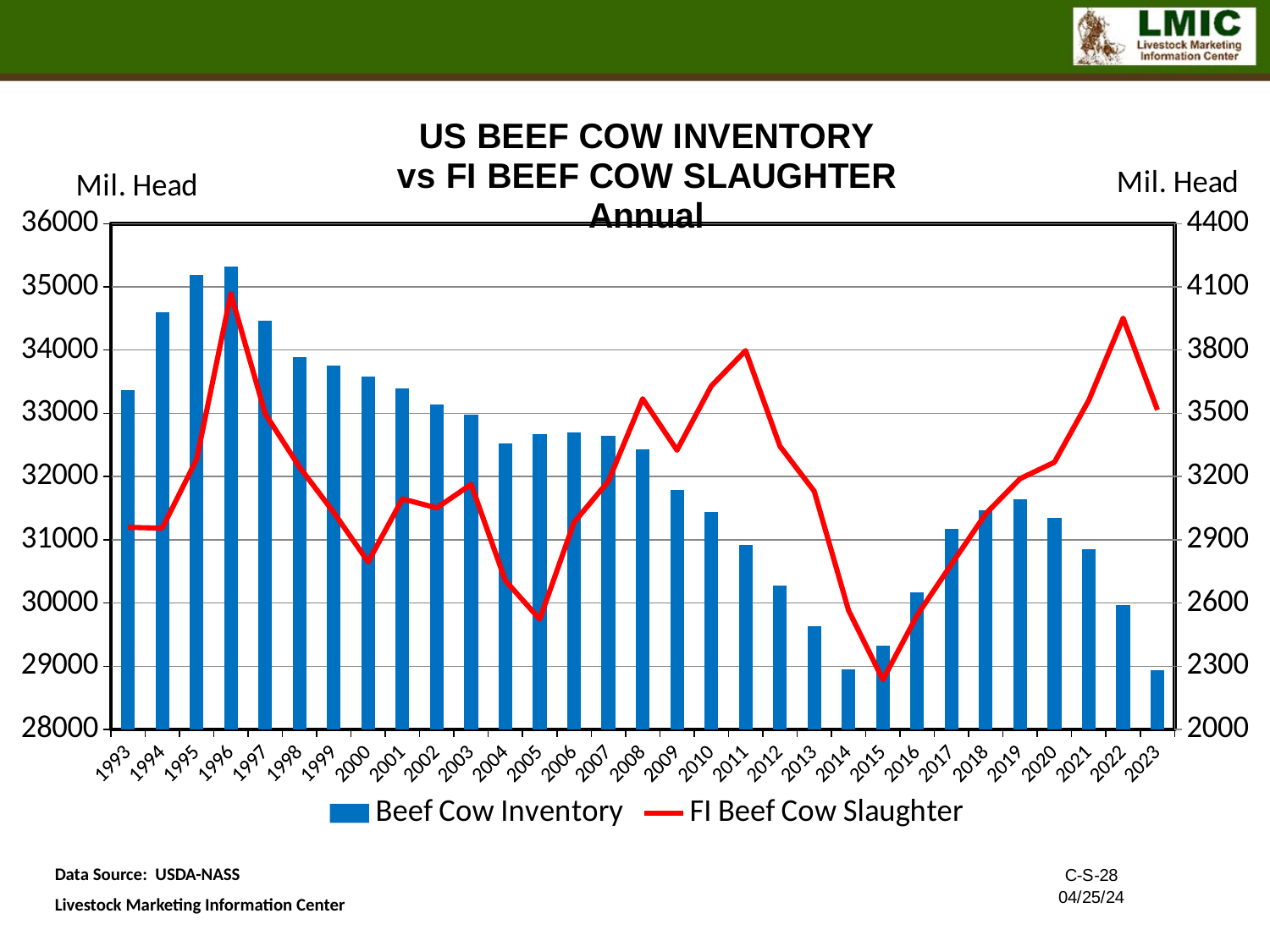
Which year has the larger Beef Cow Inventory, 1994 or 1995? 1995 Is the Beef Cow Inventory value for 2015 greater or less than 30000? less What is the title of the chart? US BEEF COW INVENTORY vs FI BEEF COW SLAUGHTER Annual Do the Beef Cow Inventory bars generally rise or fall from 1996 to 2014? fall Which year has the lowest value on the FI Beef Cow Slaughter line? 2015 Is the FI Beef Cow Slaughter value for 2011 greater or less than 3500? greater How many years are shown along the x axis? 31 Is the Beef Cow Inventory value for 1996 greater or less than 35000? greater How many series does the legend list? 2 What kind of chart is shown on the slide? A combined bar and line chart Which year has the highest Beef Cow Inventory bar? 1996